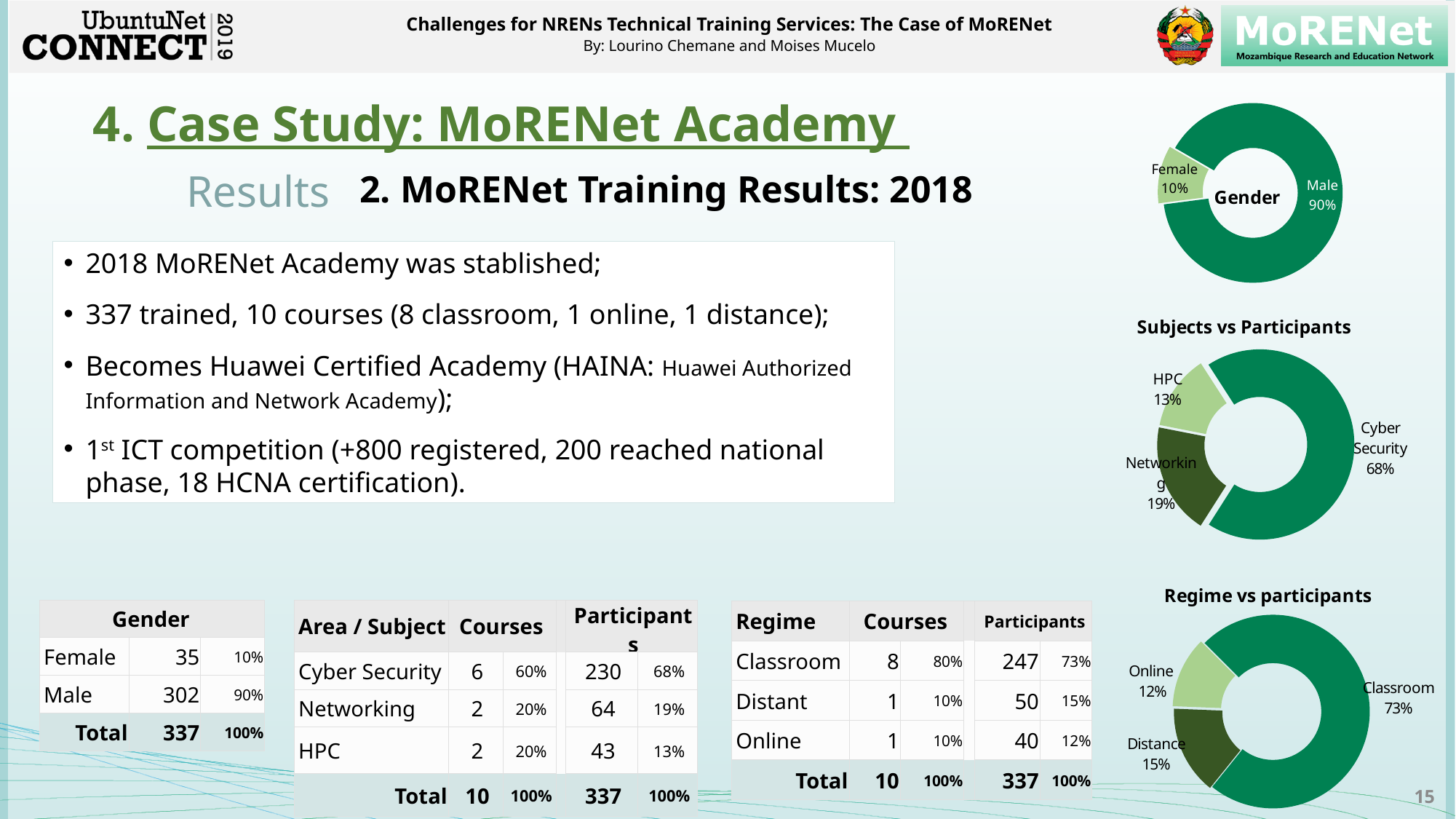
In the Gender chart, what share of the donut is Female? 10% In the Regime vs participants chart, what share is Classroom? 73% In the Subjects vs Participants chart, which subject has the smallest slice? HPC In the Gender chart, which category has the largest slice? Male In the Regime vs participants chart, what share is Distance? 15% In the Subjects vs Participants chart, how many subjects are shown? 3 In the Subjects vs Participants chart, what is the difference between the Cyber Security and Networking shares? 49% What kind of chart is the Regime vs participants chart? Donut (pie) chart In the Regime vs participants chart, which is larger, Online or Distance? Distance